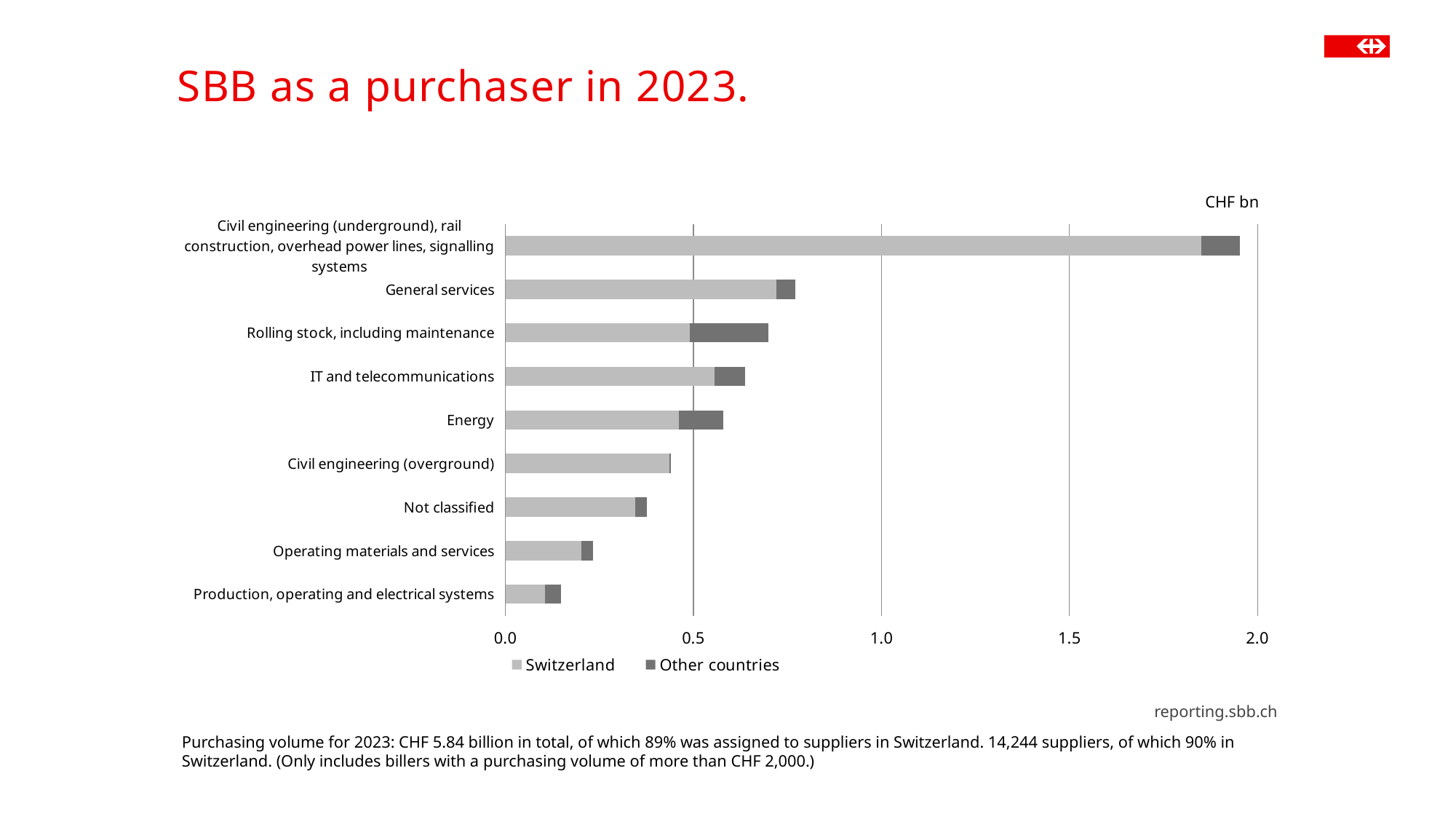
Is the total value for Rolling stock, including maintenance greater or less than 1.0? less What kind of chart is shown on the slide? Stacked bar chart How many series does the chart legend list? 2 Which has the larger total purchasing volume: Rolling stock, including maintenance or Energy? Rolling stock, including maintenance Is the total value for Civil engineering (overground) greater or less than 0.5? less Is the total value for Civil engineering (underground), rail construction, overhead power lines, signalling systems greater or less than 1.5? greater How many purchasing categories are shown on the chart? 9 Which category has the largest Other countries segment? Rolling stock, including maintenance Which category has the highest total purchasing volume? Civil engineering (underground), rail construction, overhead power lines, signalling systems Which category has the lowest total purchasing volume? Production, operating and electrical systems What unit is indicated above the chart's axis? CHF bn